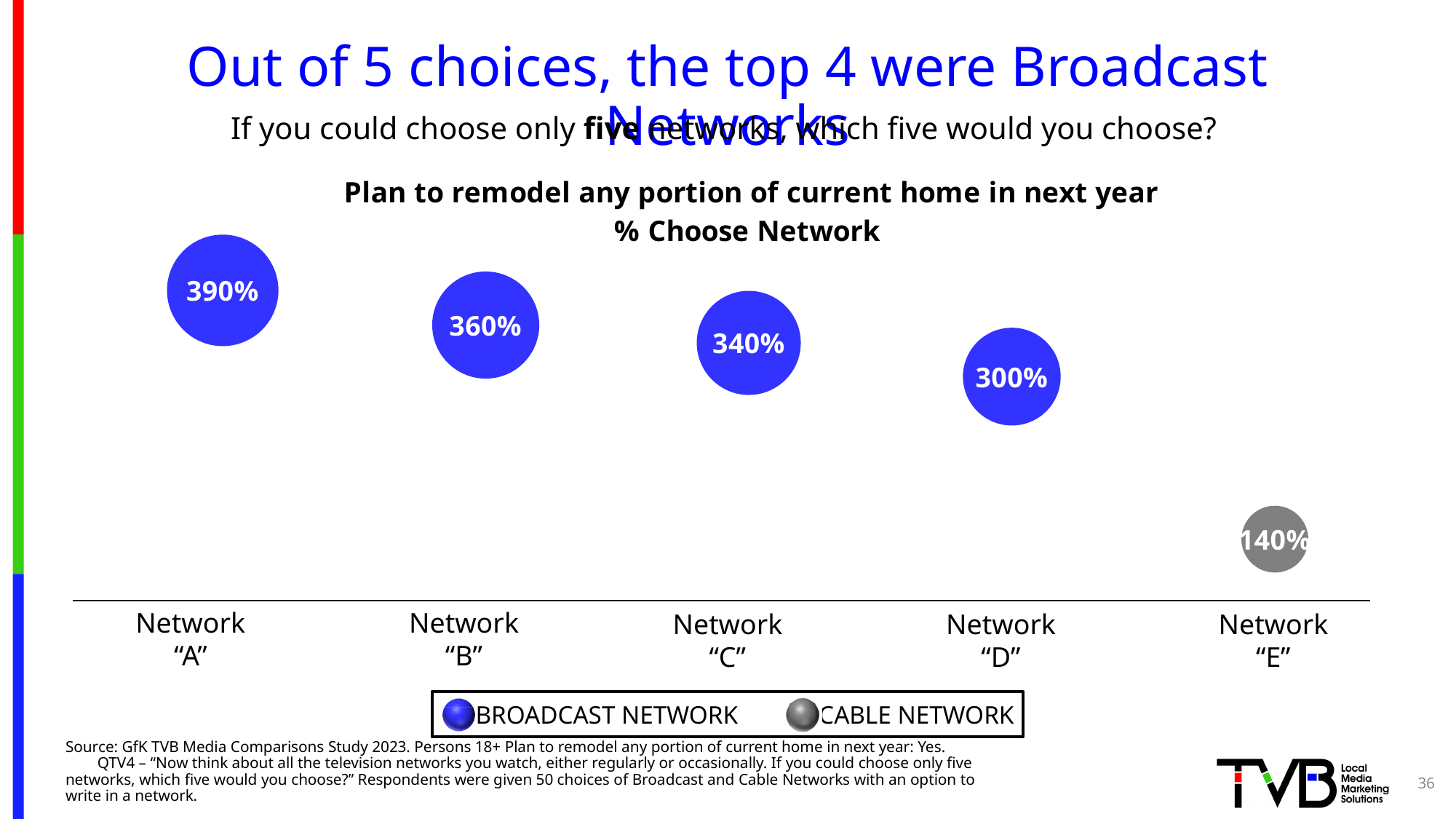
What is the value for Network "E"? 140% Which is larger, the value for Network "B" or Network "C"? Network "B" What is the difference between the values for Network "A" and Network "E"? 250% Which network is shown as a Cable Network in the chart? Network "E" What is the difference between the values for Network "B" and Network "D"? 60% Which network has the lowest value? Network "E" Which network has the highest value? Network "A" Do the values rise or fall from Network "A" to Network "E"? fall How many networks are plotted in the chart? 5 How many entries does the legend list? 2 What is the value for Network "C"? 340% What is the value for Network "A"? 390%